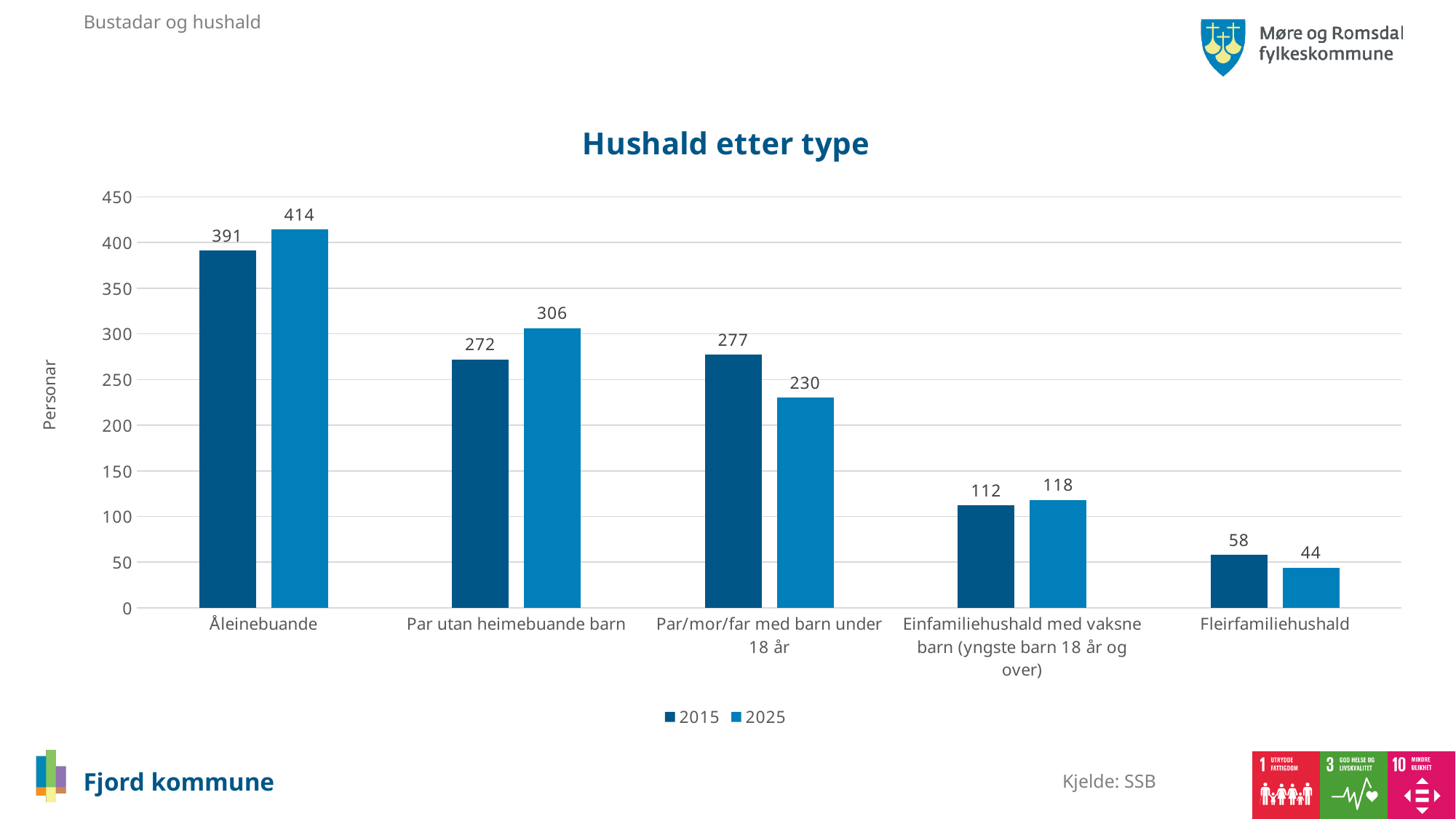
How many series does the legend list? 2 What is the difference between the 2025 and 2015 values for Par utan heimebuande barn? 34 How many household categories are shown on the x axis? 5 What is the 2025 value for Par/mor/far med barn under 18 år? 230 Which category has the highest 2025 value? Åleinebuande What is the title of the chart? Hushald etter type Which is larger for Par/mor/far med barn under 18 år: the 2015 value or the 2025 value? 2015 What kind of chart is shown? Bar chart What is the 2015 value for Åleinebuande? 391 What is the label on the y axis? Personar What is the 2025 value for Fleirfamiliehushald? 44 Which category has the lowest 2015 value? Fleirfamiliehushald